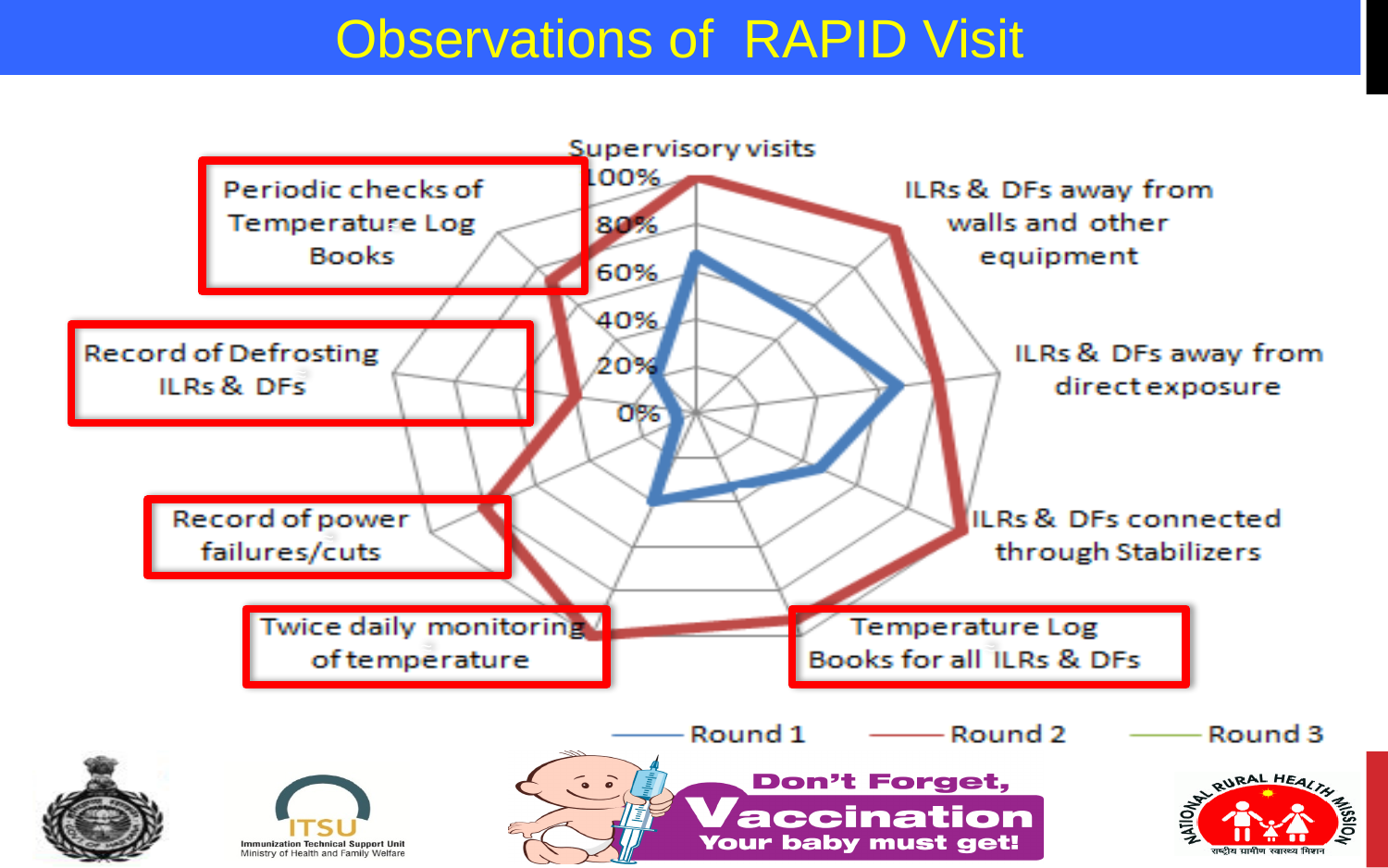
What is the title of the slide containing the chart? Observations of RAPID Visit Is the Round 1 value for ILRs & DFs away from direct exposure greater or less than 40%? greater Is the Round 1 value for Record of Defrosting ILRs & DFs greater or less than 40%? less What colour is the Round 1 line in the chart? Blue For Record of power failures/cuts, which series has the larger value, Round 1 or Round 2? Round 2 Is the Round 1 value for Supervisory visits greater or less than 80%? less What kind of chart is shown on the slide? Radar chart For Supervisory visits, which series has the larger value, Round 1 or Round 2? Round 2 How many series does the legend of the chart list? 3 How many categories (axes) does the radar chart have? 9